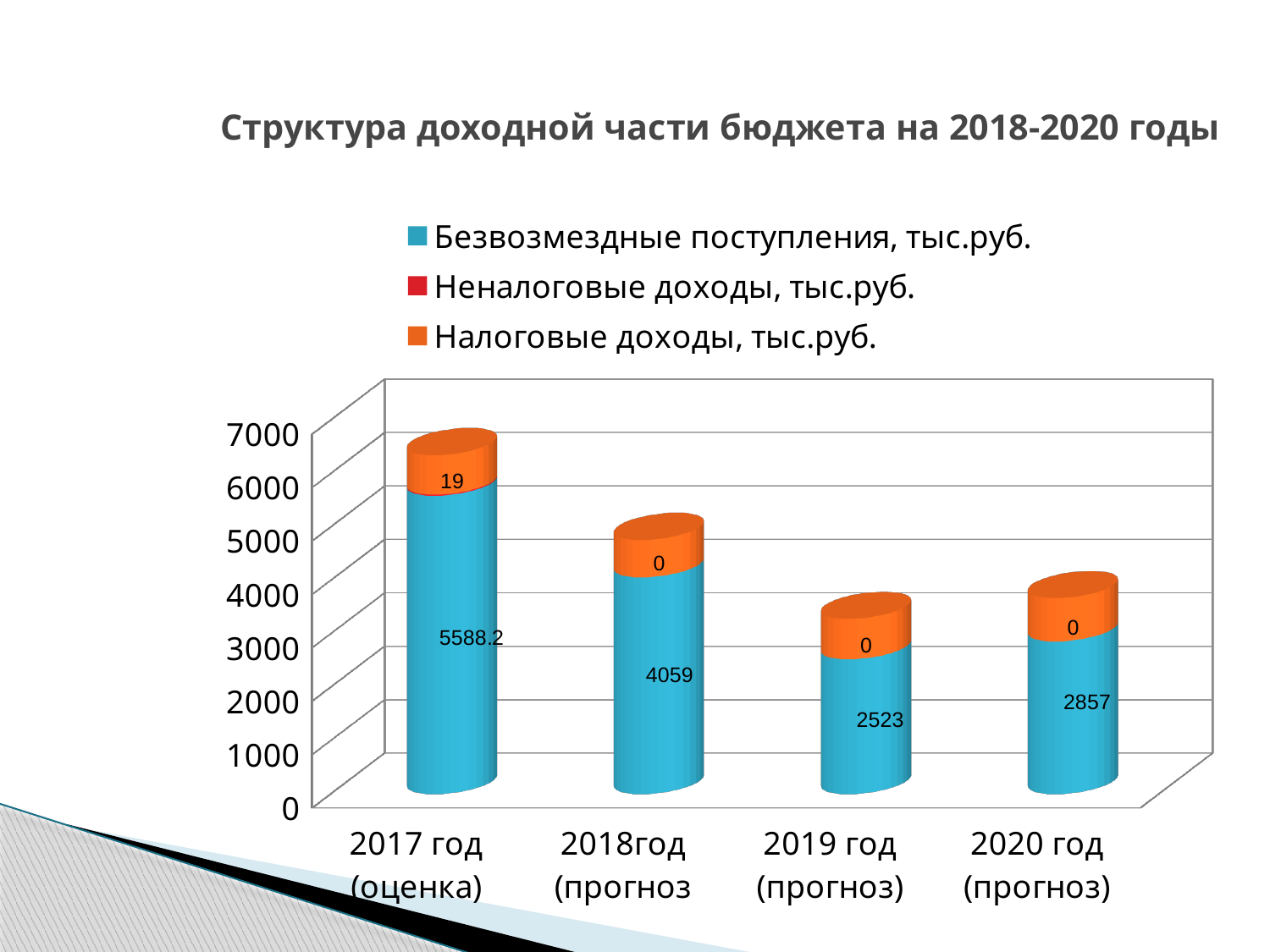
Which has the larger value of Безвозмездные поступления, тыс.руб.: 2018год (прогноз) or 2020 год (прогноз)? 2018год (прогноз) What is the value of Безвозмездные поступления, тыс.руб. for 2020 год (прогноз)? 2857 What is the value of Безвозмездные поступления, тыс.руб. for 2018год (прогноз)? 4059 What kind of chart is shown on the slide? Bar chart What is the difference in Безвозмездные поступления, тыс.руб. between 2017 год (оценка) and 2018год (прогноз)? 1529.2 Which year has the lowest value of Безвозмездные поступления, тыс.руб.? 2019 год (прогноз) What is the value of Безвозмездные поступления, тыс.руб. for 2019 год (прогноз)? 2523 Which year has the highest value of Безвозмездные поступления, тыс.руб.? 2017 год (оценка) What is the value of Безвозмездные поступления, тыс.руб. for 2017 год (оценка)? 5588.2 How many series does the chart legend list? 3 What is the difference in Безвозмездные поступления, тыс.руб. between 2020 год (прогноз) and 2019 год (прогноз)? 334 How many year categories are shown on the x axis of the chart? 4